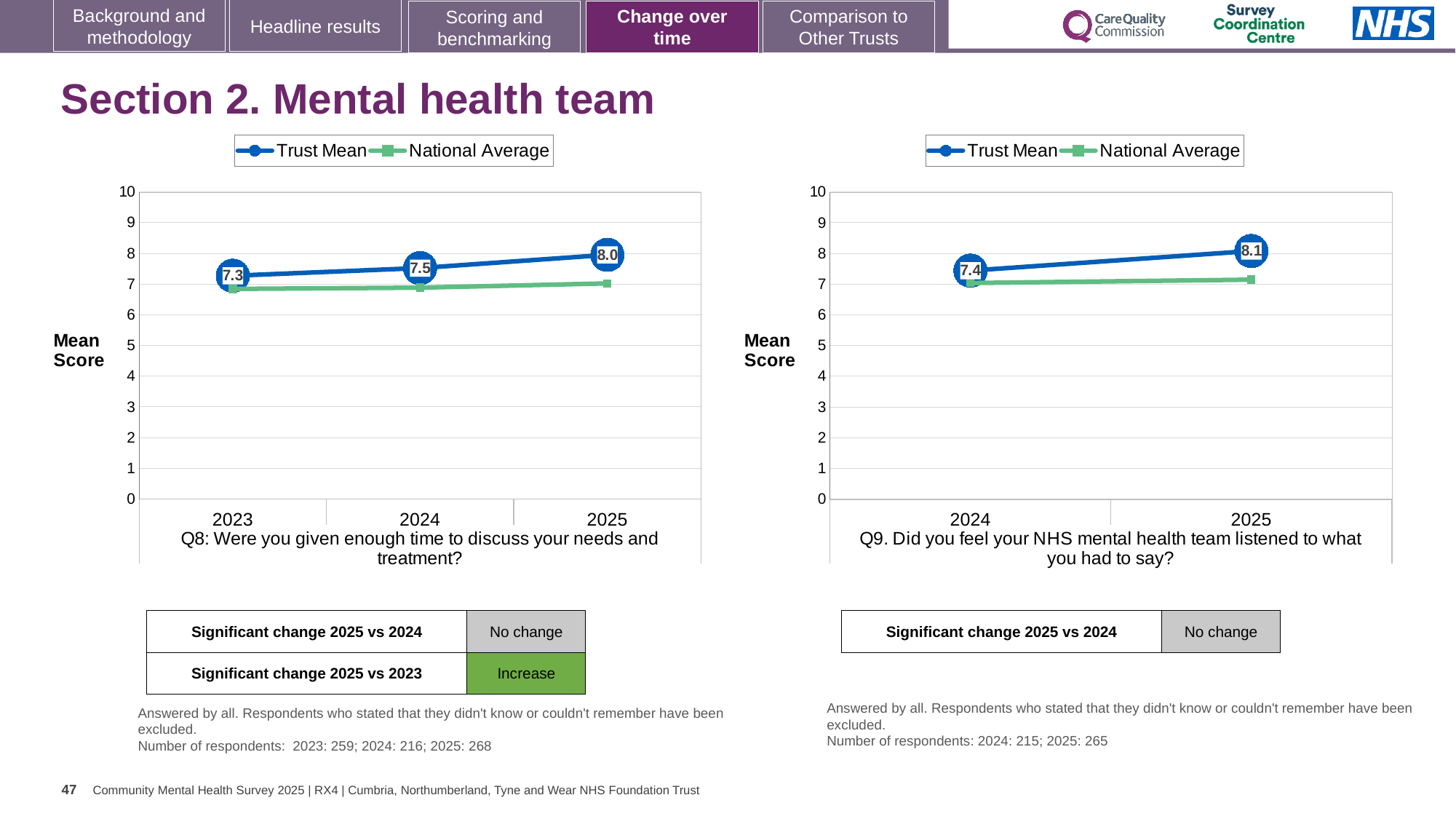
In the Q9 chart (right), what is the difference between the Trust Mean for 2025 and 2024? 0.7 In the Q9 chart (right), which is larger in 2025, the Trust Mean or the National Average? Trust Mean In the Q8 chart (left), what is the difference between the Trust Mean for 2025 and 2023? 0.7 In the Q8 chart (left), which year has the highest Trust Mean? 2025 In the Q8 chart (left), is the National Average for 2023 greater or less than 8? less In the Q8 chart (left), what is the Trust Mean for 2023? 7.3 In the Q8 chart (left), which year has the lowest Trust Mean? 2023 In the Q8 chart (left), what is the Trust Mean for 2025? 8.0 How many series does the legend of the Q9 chart (right) list? 2 How many years are shown on the x axis of the Q8 chart (left)? 3 In the Q9 chart (right), what is the Trust Mean for 2025? 8.1 In the Q9 chart (right), what is the Trust Mean for 2024? 7.4